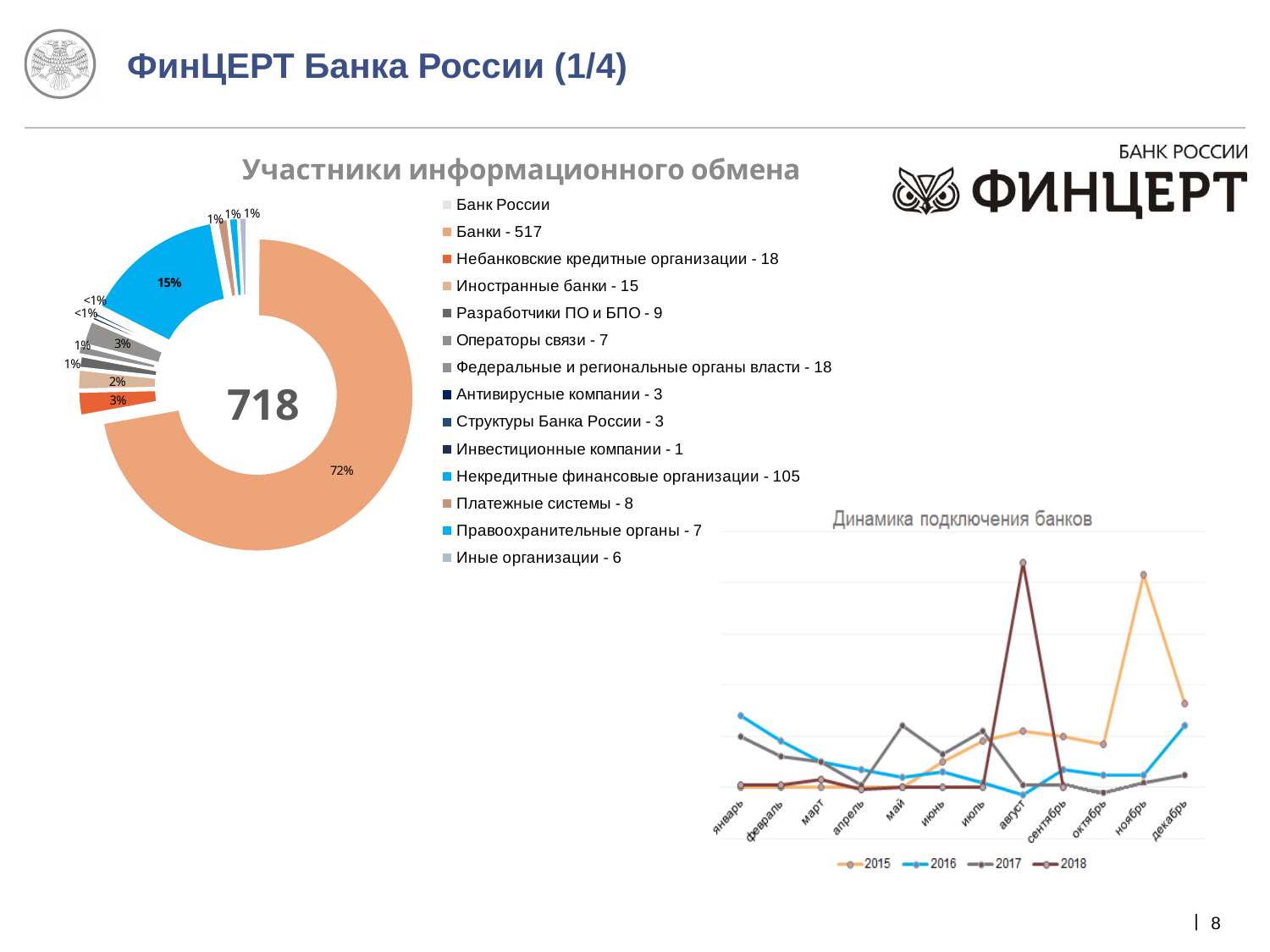
In the 'Участники информационного обмена' chart, what is the difference between the number of 'Банки' and the number of 'Некредитные финансовые организации'? 412 In the 'Участники информационного обмена' chart, which has more participants: 'Небанковские кредитные организации' or 'Иностранные банки'? Небанковские кредитные организации In the 'Участники информационного обмена' chart, what share of the total do 'Некредитные финансовые организации' represent? 15% In the 'Участники информационного обмена' chart, what share of the total do 'Банки' represent? 72% What kind of chart is the 'Участники информационного обмена' chart? Donut (pie) chart In the 'Участники информационного обмена' chart, how many participants are listed for 'Некредитные финансовые организации'? 105 In the 'Участники информационного обмена' chart, which category has the largest number of participants? Банки In the 'Динамика подключения банков' chart, which series has its highest peak in август (August)? 2018 How many series does the legend of the 'Динамика подключения банков' chart list? 4 What total number is shown in the centre of the 'Участники информационного обмена' donut chart? 718 In the 'Участники информационного обмена' chart, how many participants are listed for 'Банки'? 517